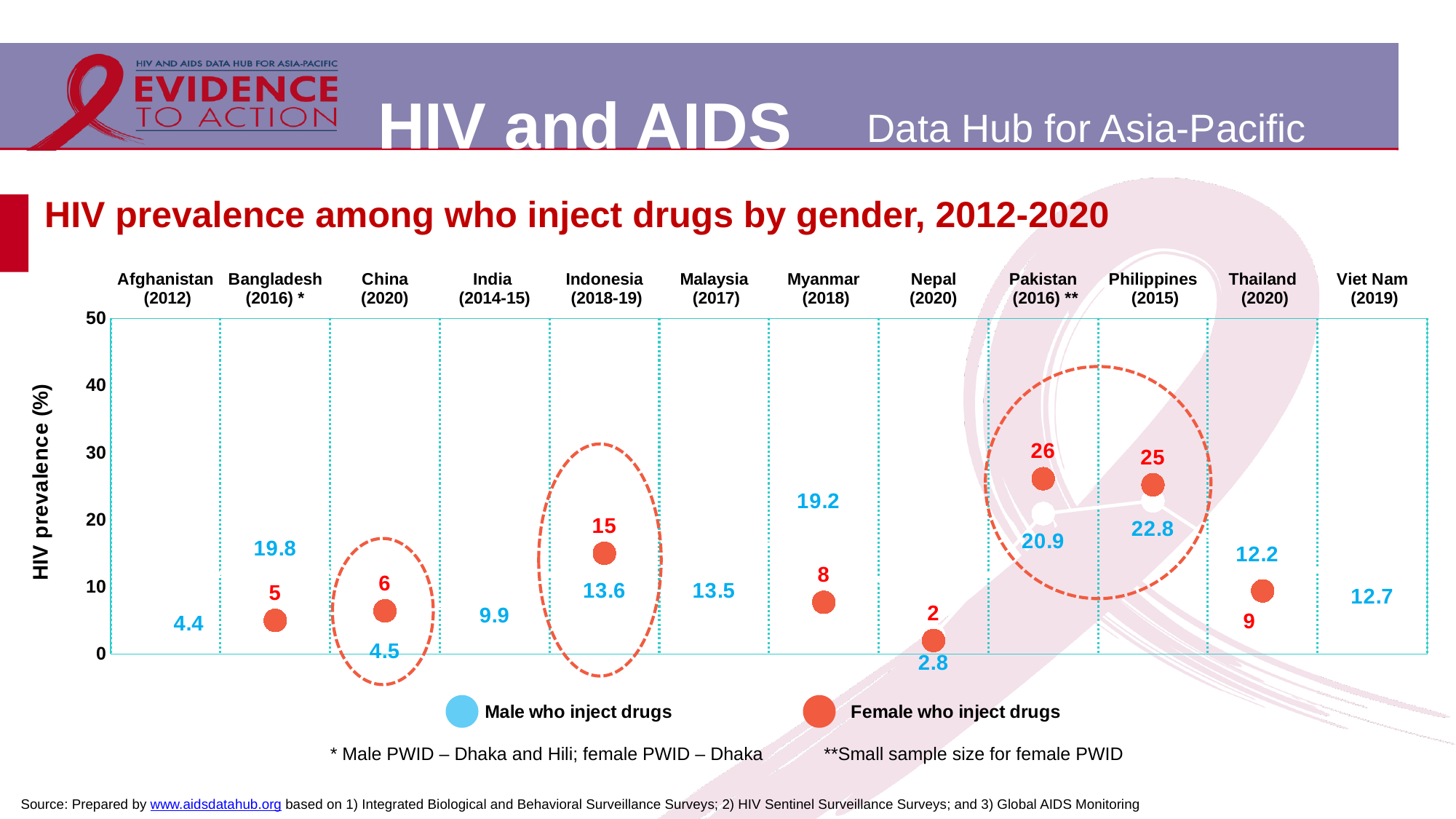
What is the HIV prevalence among male who inject drugs in Viet Nam (2019)? 12.7 Which country has the highest HIV prevalence among female who inject drugs? Pakistan What is the difference between the male and female HIV prevalence values for Bangladesh (2016)? 14.8 What is the HIV prevalence among female who inject drugs in Pakistan (2016)? 26 In Indonesia (2018-19), which is larger: the HIV prevalence among male or female who inject drugs? Female How many countries are shown on the chart? 12 How many series does the legend list? 2 What is the difference between the female and male HIV prevalence values for Pakistan (2016)? 5.1 Which country has the highest HIV prevalence among male who inject drugs? Philippines What colour represents female who inject drugs in the chart? Red What is the HIV prevalence among male who inject drugs in Bangladesh (2016)? 19.8 Which country has the lowest HIV prevalence among male who inject drugs? Nepal